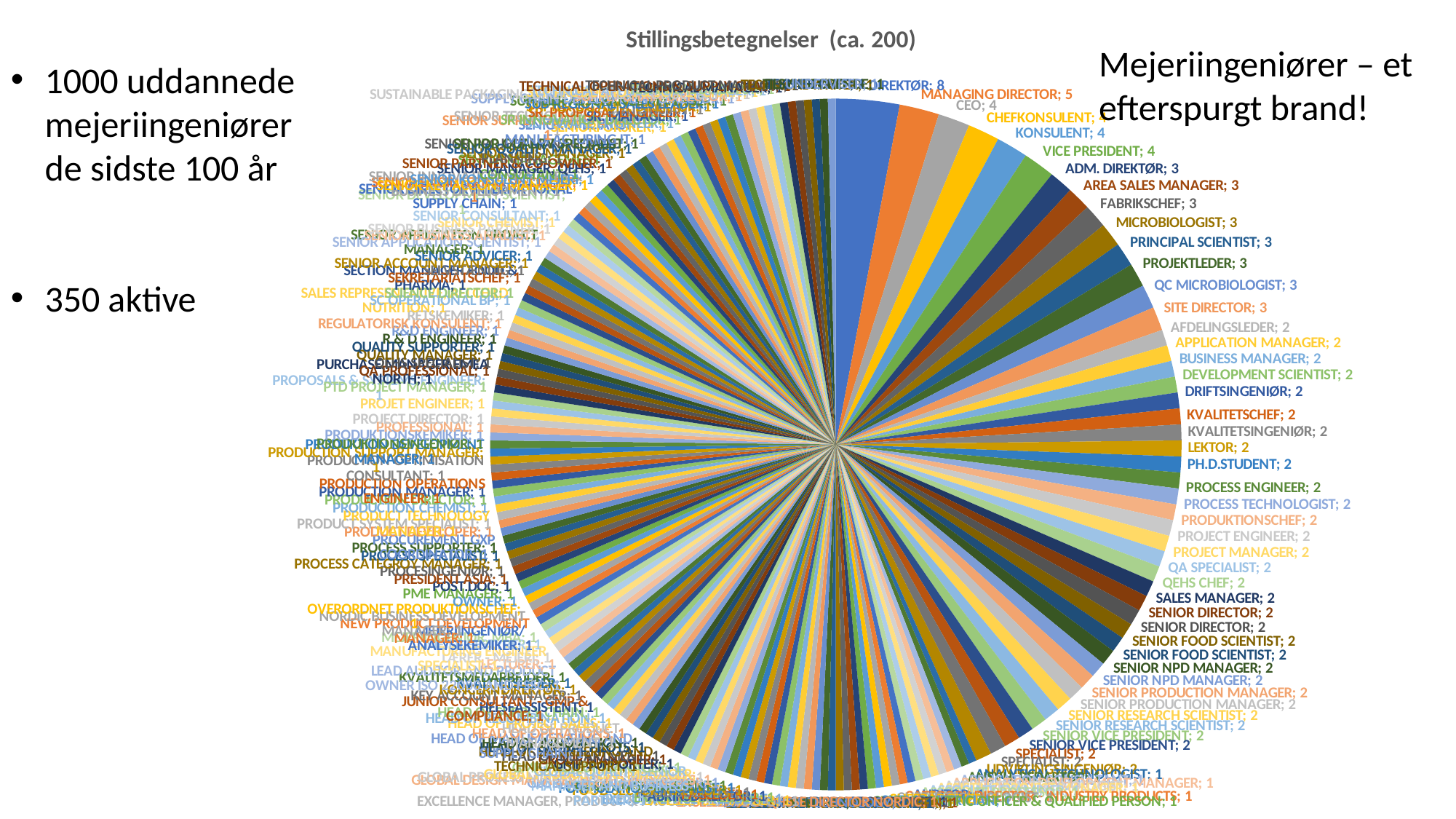
What value is shown for PROJEKTLEDER in the pie chart? 3 What value is shown for DIREKTØR in the pie chart? 8 What value is shown for MANAGING DIRECTOR in the pie chart? 5 What value is shown for SITE DIRECTOR in the pie chart? 3 What value is shown for VICE PRESIDENT in the pie chart? 4 Which job title has the largest slice in the pie chart? DIREKTØR Which is larger in the pie chart, DIREKTØR or MANAGING DIRECTOR? DIREKTØR What kind of chart is shown on the slide? pie chart What is the difference between the values for DIREKTØR and MANAGING DIRECTOR? 3 What is the title of the chart? Stillingsbetegnelser (ca. 200) What value is shown for KONSULENT in the pie chart? 4 What value is shown for PH.D.STUDENT in the pie chart? 2